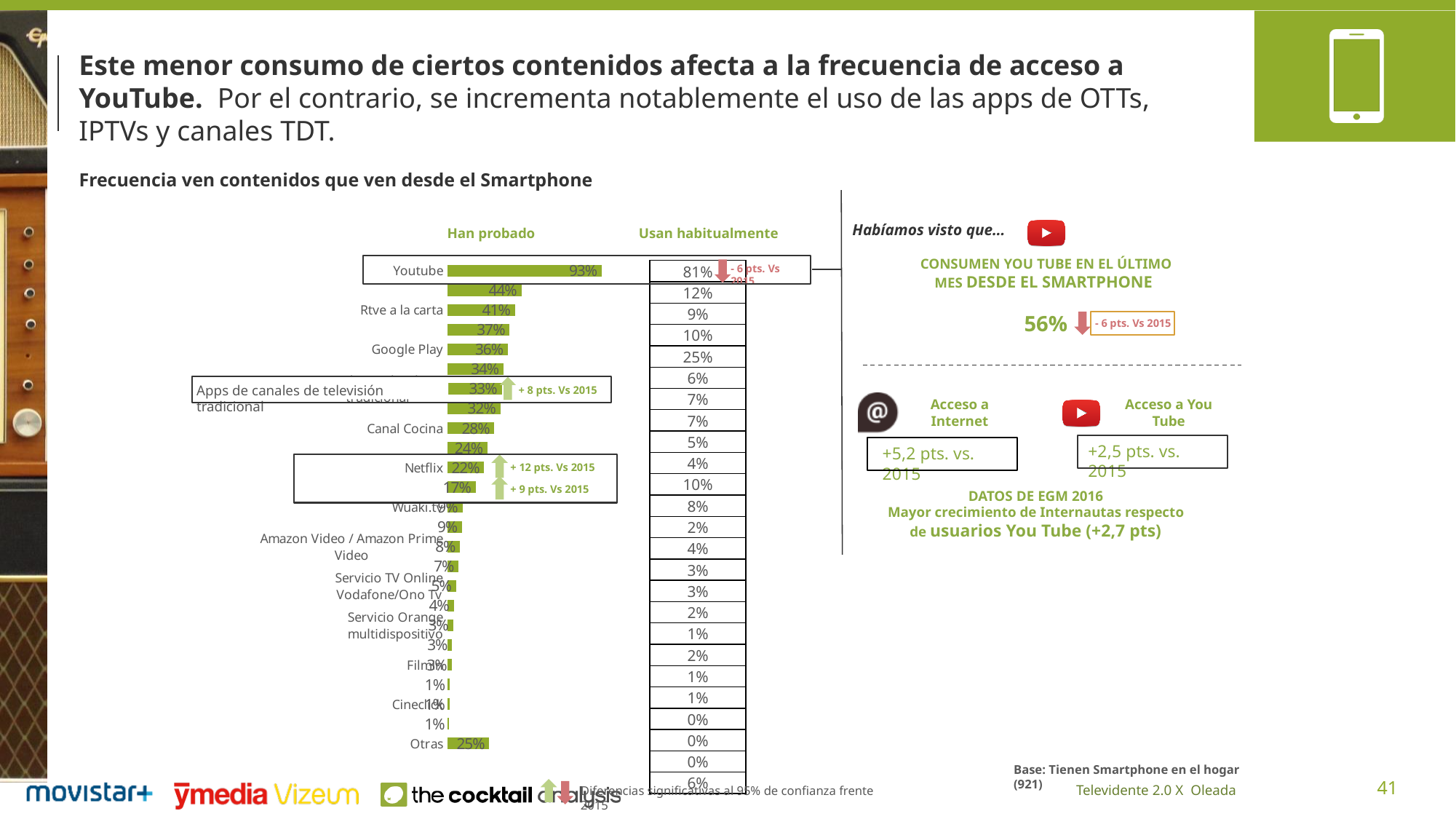
In the 'Usan habitualmente' column, what is the value for Youtube? 81% In the 'Han probado' bar chart, what is the value for Otras? 25% In the 'Han probado' bar chart, what is the value for Google Play? 36% In the 'Han probado' bar chart, what is the value for Netflix? 22% In the 'Han probado' bar chart, what is the value for Youtube? 93% What change versus 2015 is annotated next to the Netflix bar in the 'Han probado' chart? + 12 pts. Vs 2015 What kind of chart is used to show the 'Han probado' values? bar chart In the 'Han probado' bar chart, which is larger: Google Play or Canal Cocina? Google Play In the 'Han probado' bar chart, what is the value for Canal Cocina? 28% In the 'Han probado' bar chart, which category has the highest value? Youtube In the 'Han probado' bar chart, what is the value for Rtve a la carta? 41% In the 'Han probado' bar chart, what is the difference between the values for Youtube and Rtve a la carta? 52 percentage points